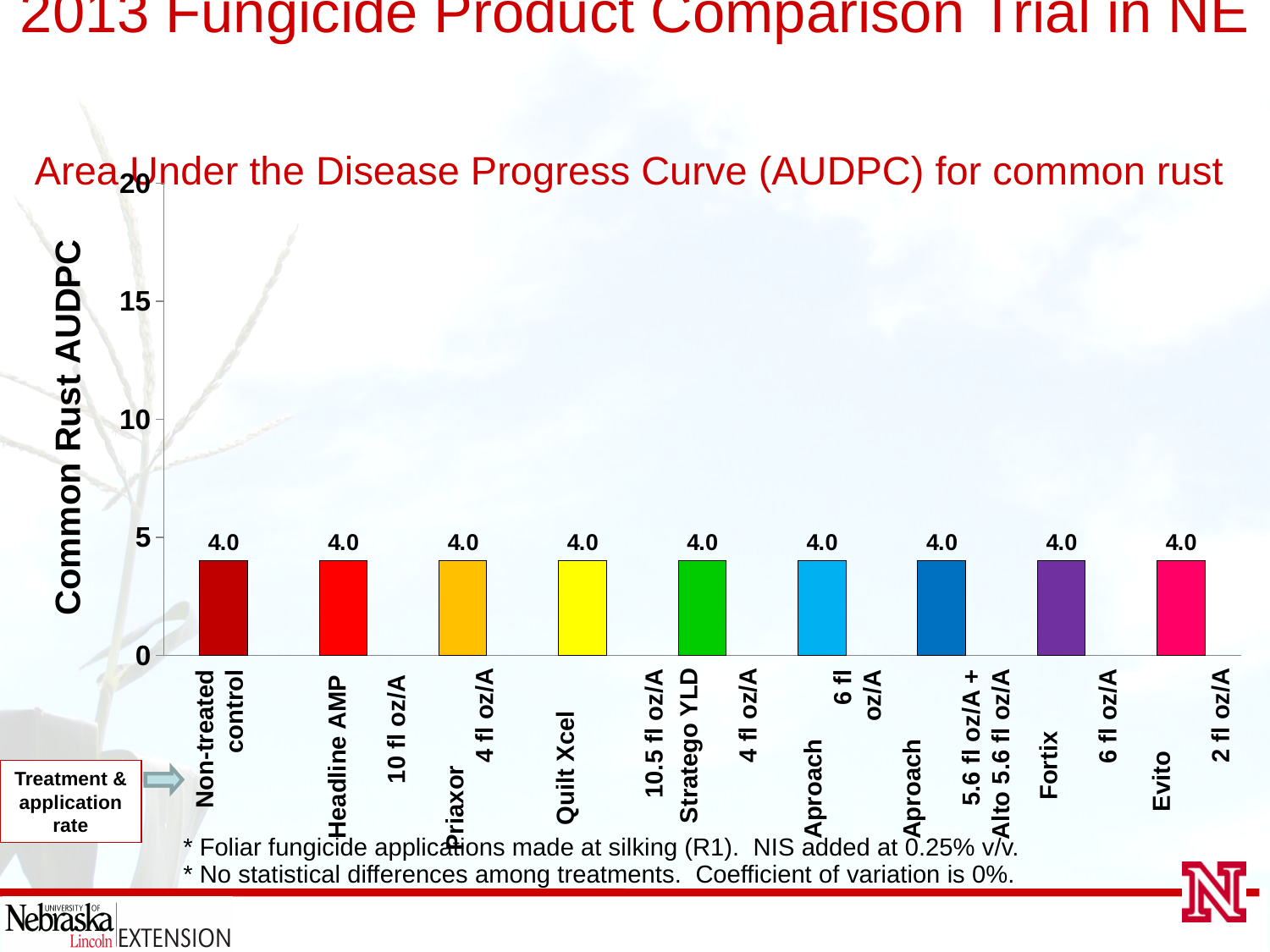
What is the difference between the AUDPC values for Quilt Xcel and Stratego YLD? 0.0 What kind of chart is shown on the slide? bar chart How many treatments (bars) are shown in the chart? 9 Is the AUDPC value for Approach (6 fl oz/A) greater or less than 10? less What is the label on the vertical axis of the chart? Common Rust AUDPC What is the Common Rust AUDPC value for Evito? 4.0 What is the Common Rust AUDPC value for Fortix? 4.0 What is the Common Rust AUDPC value for Headline AMP? 4.0 Is the AUDPC value for Priaxor greater or less than 5? less What is the Common Rust AUDPC value for the Non-treated control? 4.0 What is the title of the chart? Area Under the Disease Progress Curve (AUDPC) for common rust Do the AUDPC values rise, fall, or stay the same across the treatments from left to right? stay the same